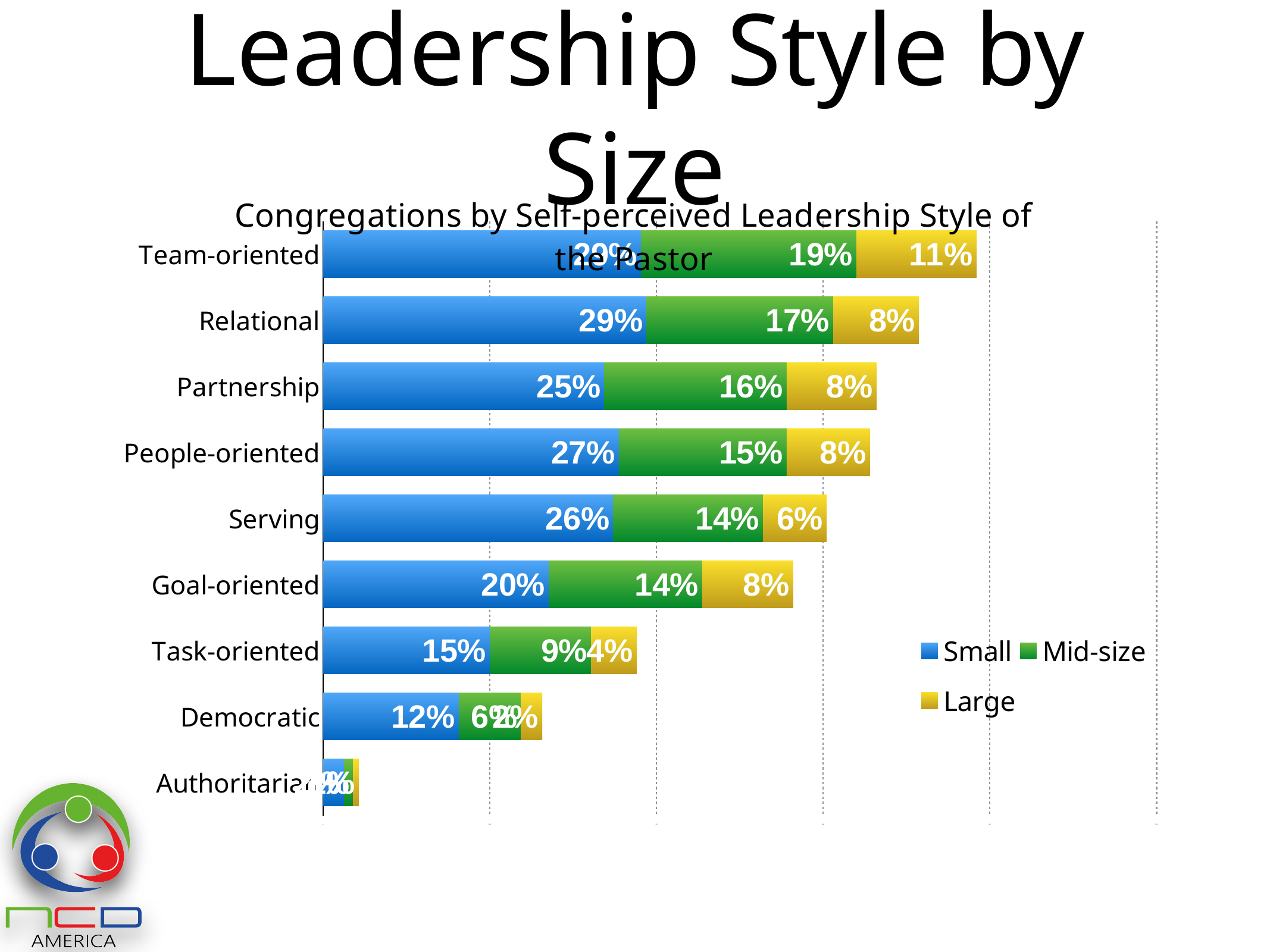
Which is larger, the Mid-size value for Partnership or the Mid-size value for Serving? Partnership Which leadership style has the highest Large value? Team-oriented Which series is shown in yellow in the legend? Large What type of chart is shown on the slide? stacked bar chart What is the Large value for Serving? 6% How many leadership style categories are plotted? 9 What is the total of the stacked bar for Relational? 54% What is the difference between the Small values for Relational and Goal-oriented? 9% What is the Mid-size value for Team-oriented? 19% How many series does the legend list? 3 What is the Small value for Relational? 29% What is the Small value for Task-oriented? 15%